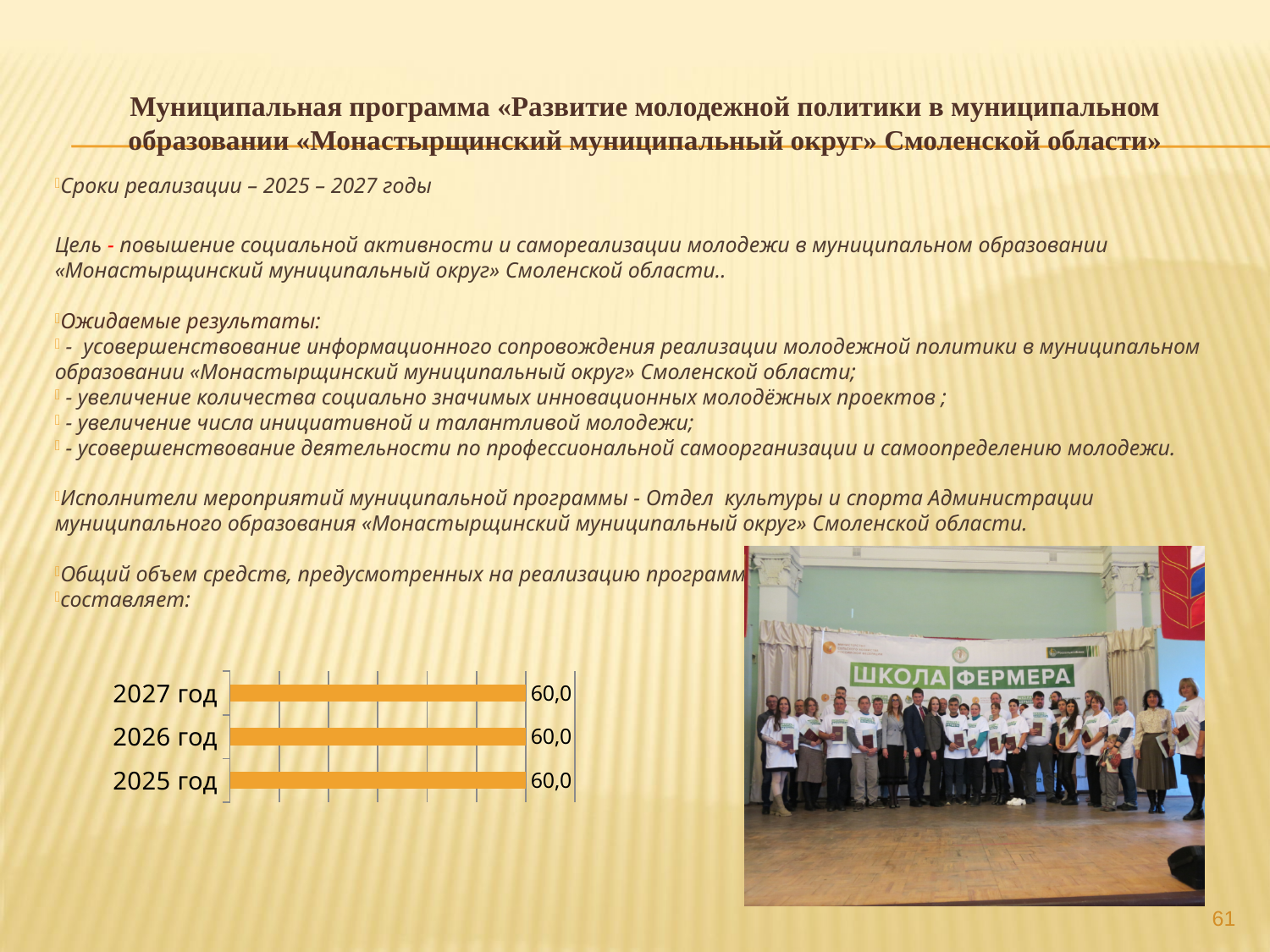
Is the value for 2027 год larger than, smaller than, or equal to the value for 2025 год? equal What kind of chart is shown on the slide? bar chart What is the value for 2025 год? 60,0 What colour are the bars in the chart? orange What is the value for 2027 год? 60,0 What is the value for 2026 год? 60,0 How many categories (years) are shown in the chart? 3 Do the values rise, fall, or stay the same from 2025 год to 2027 год? stay the same What is the difference between the values for 2026 год and 2025 год? 0,0 Which year is listed at the bottom of the chart? 2025 год